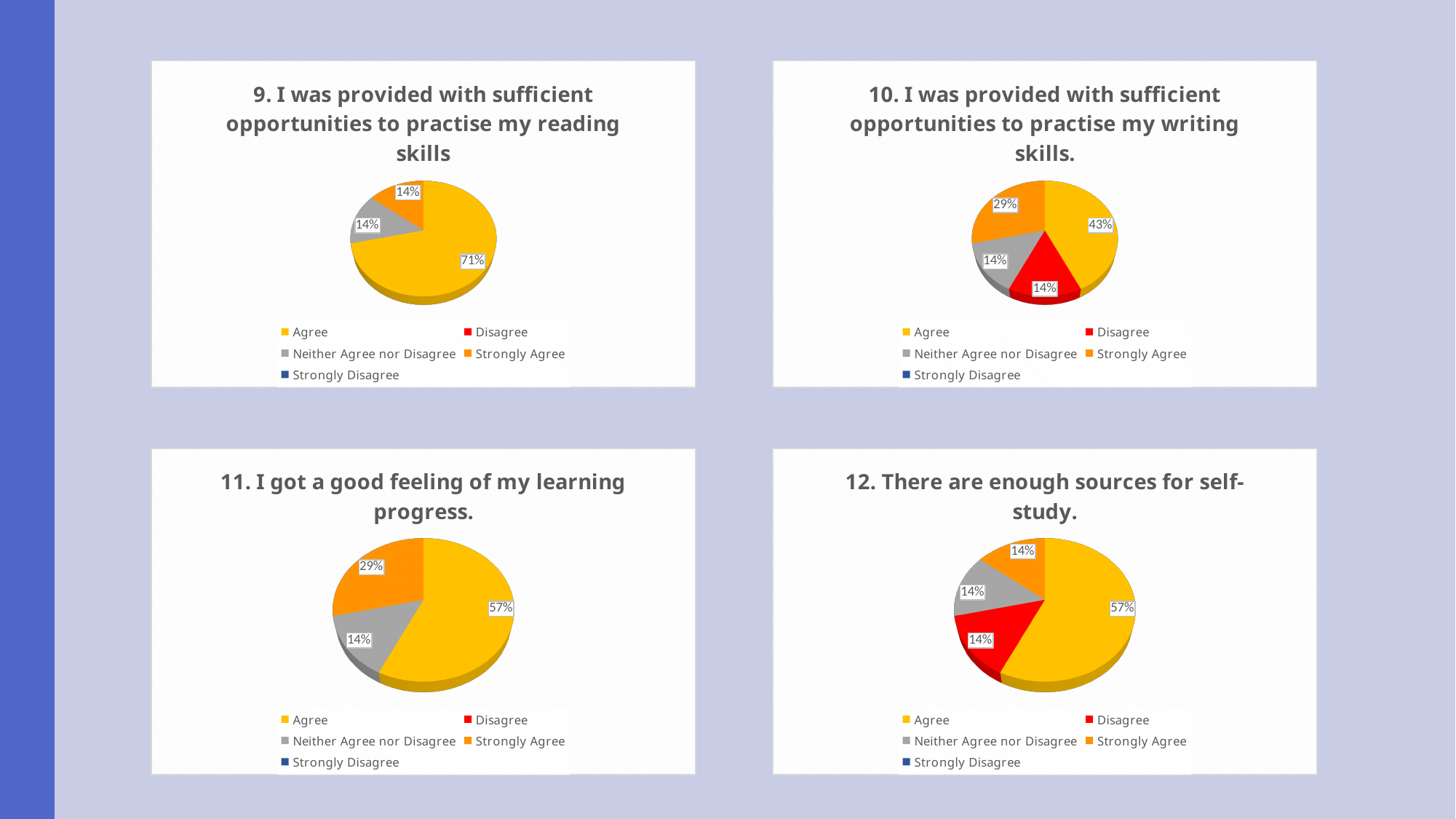
In the chart titled "10. I was provided with sufficient opportunities to practise my writing skills.", what share of responses is Disagree? 14% What kind of chart is used for "12. There are enough sources for self-study."? Pie chart In the chart titled "9. I was provided with sufficient opportunities to practise my reading skills", what share of responses is Strongly Agree? 14% In the chart titled "12. There are enough sources for self-study.", what share of responses is Agree? 57% In the chart titled "11. I got a good feeling of my learning progress.", what is the difference between the Agree share and the Strongly Agree share? 28% In the chart titled "11. I got a good feeling of my learning progress.", which response category has the largest slice? Agree In the chart titled "10. I was provided with sufficient opportunities to practise my writing skills.", which is larger, the Agree share or the Strongly Agree share? Agree How many entries does the legend list in the chart titled "9. I was provided with sufficient opportunities to practise my reading skills"? 5